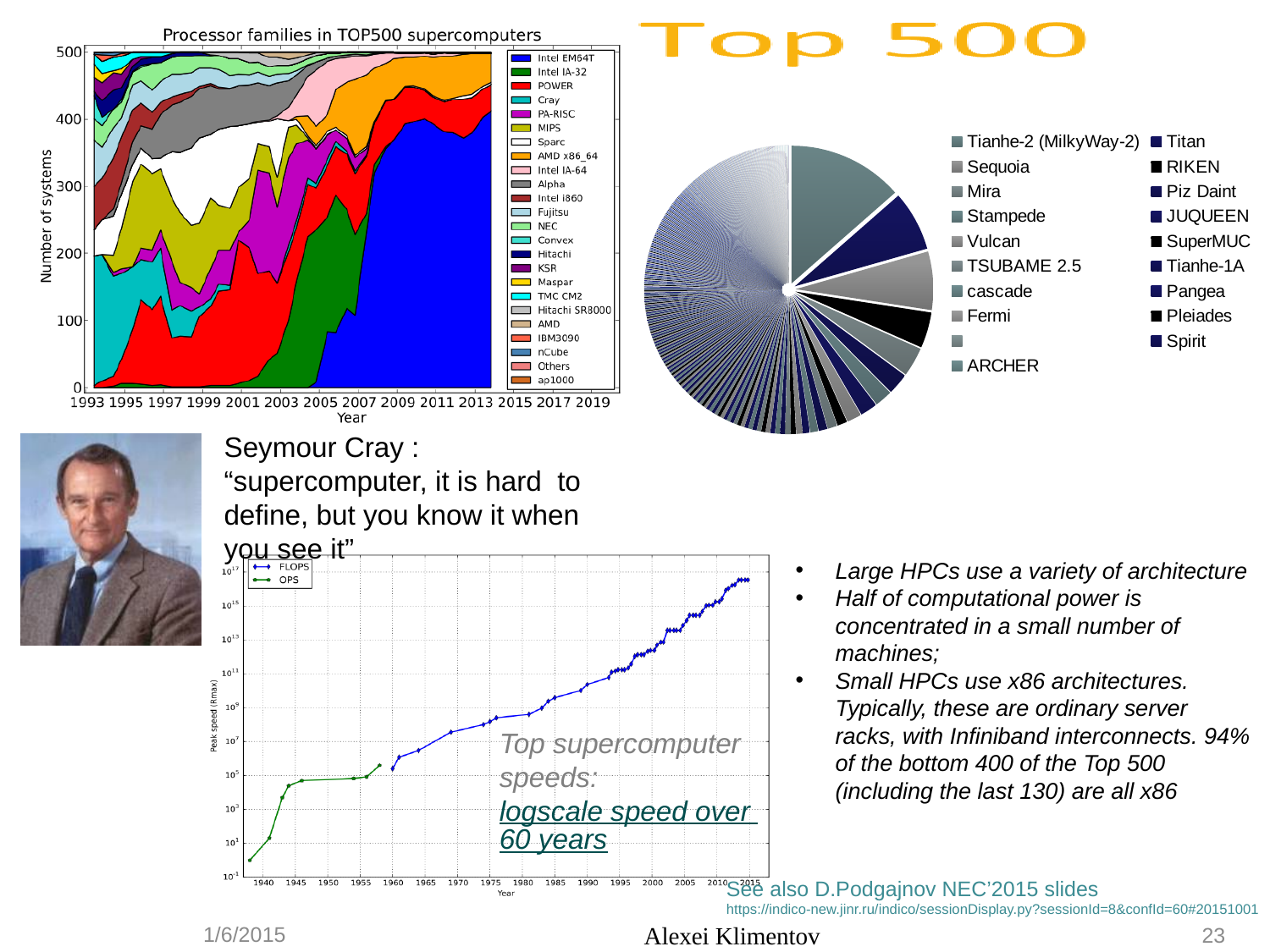
In the pie chart in the top-right of the slide, which system has the largest slice? Tianhe-2 (MilkyWay-2) In the 'Processor families in TOP500 supercomputers' chart, what is the label of the y axis? Number of systems In the 'Processor families in TOP500 supercomputers' chart, is the number of Intel EM64T systems in 1999 greater or less than 100? less What kind of chart is the 'Top supercomputer speeds' chart at the bottom of the slide? line chart In the 'Top supercomputer speeds' chart, how many series does the legend list? 2 In the 'Processor families in TOP500 supercomputers' chart, does the number of Intel EM64T systems rise or fall between 2005 and 2013? rise What kind of chart is the 'Processor families in TOP500 supercomputers' chart? stacked area chart What is the title of the chart in the top-left of the slide? Processor families in TOP500 supercomputers In the 'Top supercomputer speeds' chart, does peak speed rise or fall from 1940 to 2015? rise What kind of chart is the chart in the top-right of the slide showing Tianhe-2, Titan and Sequoia? pie chart In the 'Processor families in TOP500 supercomputers' chart, how many processor families does the legend list? 24 In the 'Processor families in TOP500 supercomputers' chart, is the number of Intel EM64T systems in 2013 greater or less than 300? greater